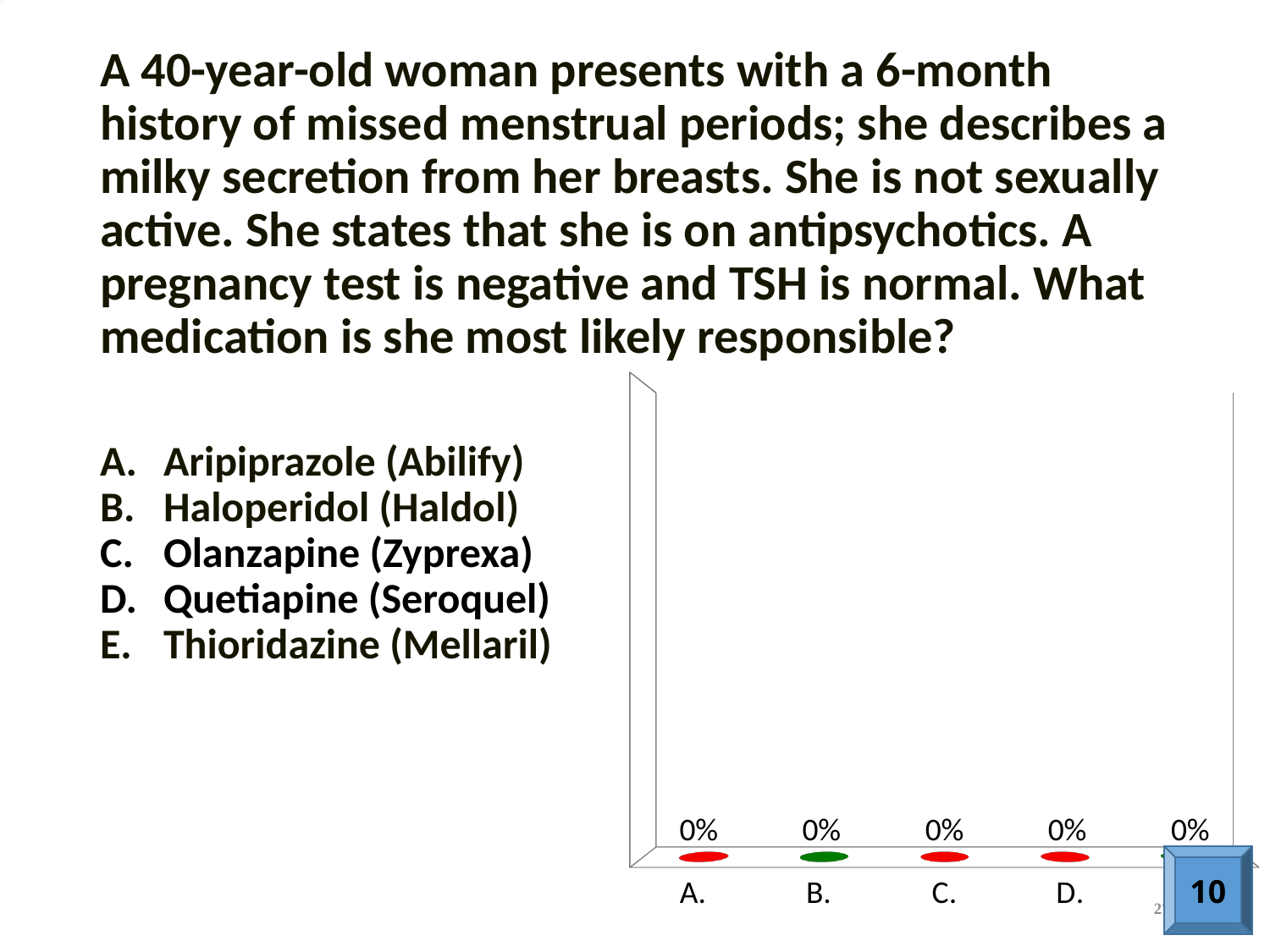
What type of chart is shown on the slide? bar chart What colour is the bar for category B.? green What is the value shown for category A.? 0% What colour is the bar for category A.? red What is the value shown for category C.? 0% How many data labels are shown on the chart? 5 What is the value shown for category D.? 0% What is the difference between the values for category A. and category B.? 0% What is the value shown for category B.? 0% What is the difference between the values for category C. and category D.? 0%